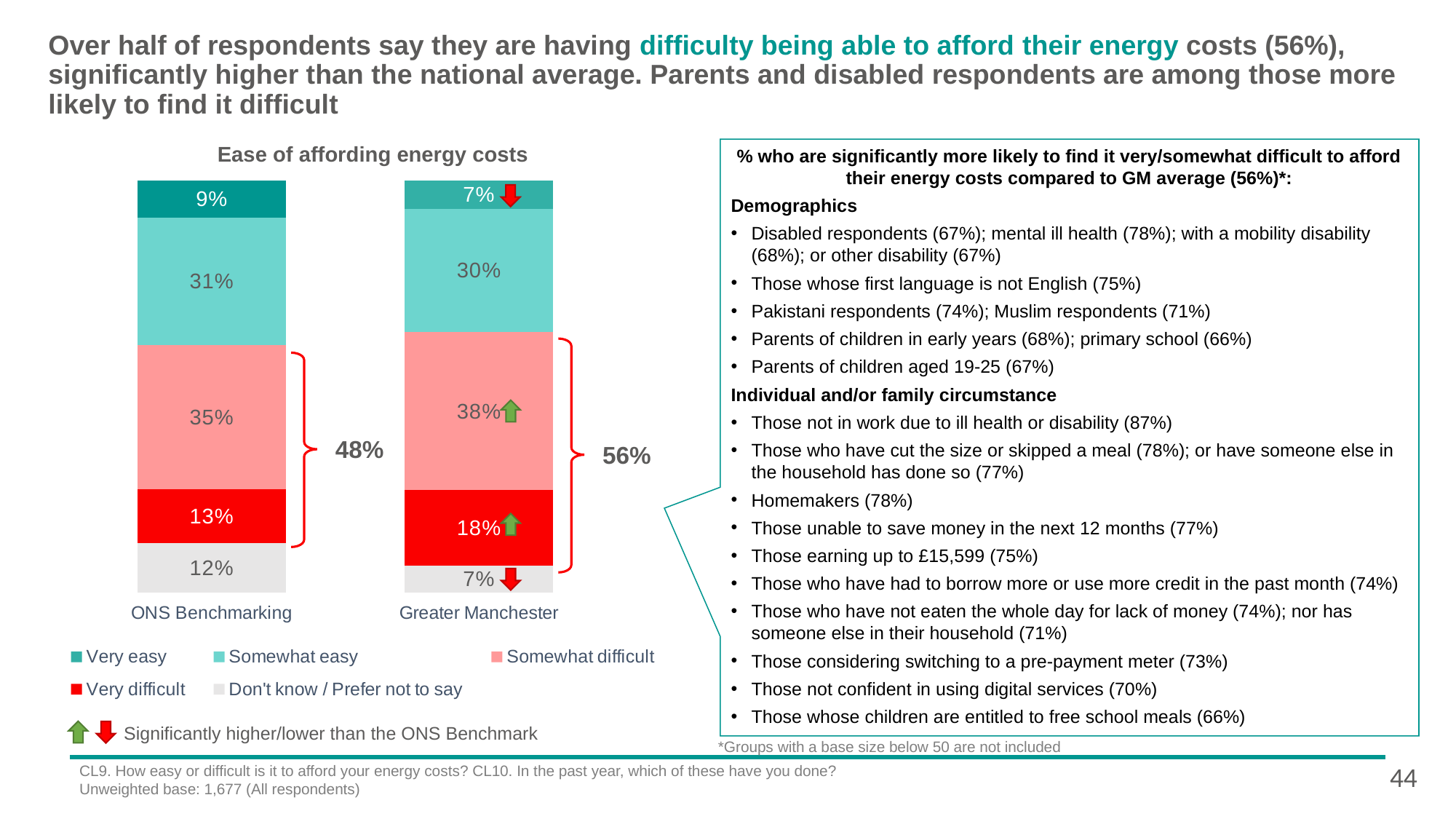
What is the difference between the 'Very difficult' values for Greater Manchester and ONS Benchmarking? 5 percentage points Which segment is the largest in the ONS Benchmarking bar? Somewhat difficult What percentage of the ONS Benchmarking respondents said it was somewhat easy to afford their energy costs? 31% Which bar has the larger 'Somewhat difficult' value, ONS Benchmarking or Greater Manchester? Greater Manchester What percentage of Greater Manchester respondents said it was very difficult to afford their energy costs? 18% What kind of chart is shown on the slide? Stacked bar chart What is the combined 'Somewhat difficult' plus 'Very difficult' share shown for Greater Manchester? 56% How many bars (categories) are shown in the chart? 2 How many series does the chart legend list? 5 What is the title of the chart? Ease of affording energy costs What is the combined 'Somewhat difficult' plus 'Very difficult' share shown for ONS Benchmarking? 48% What is the 'Very easy' value for Greater Manchester? 7%